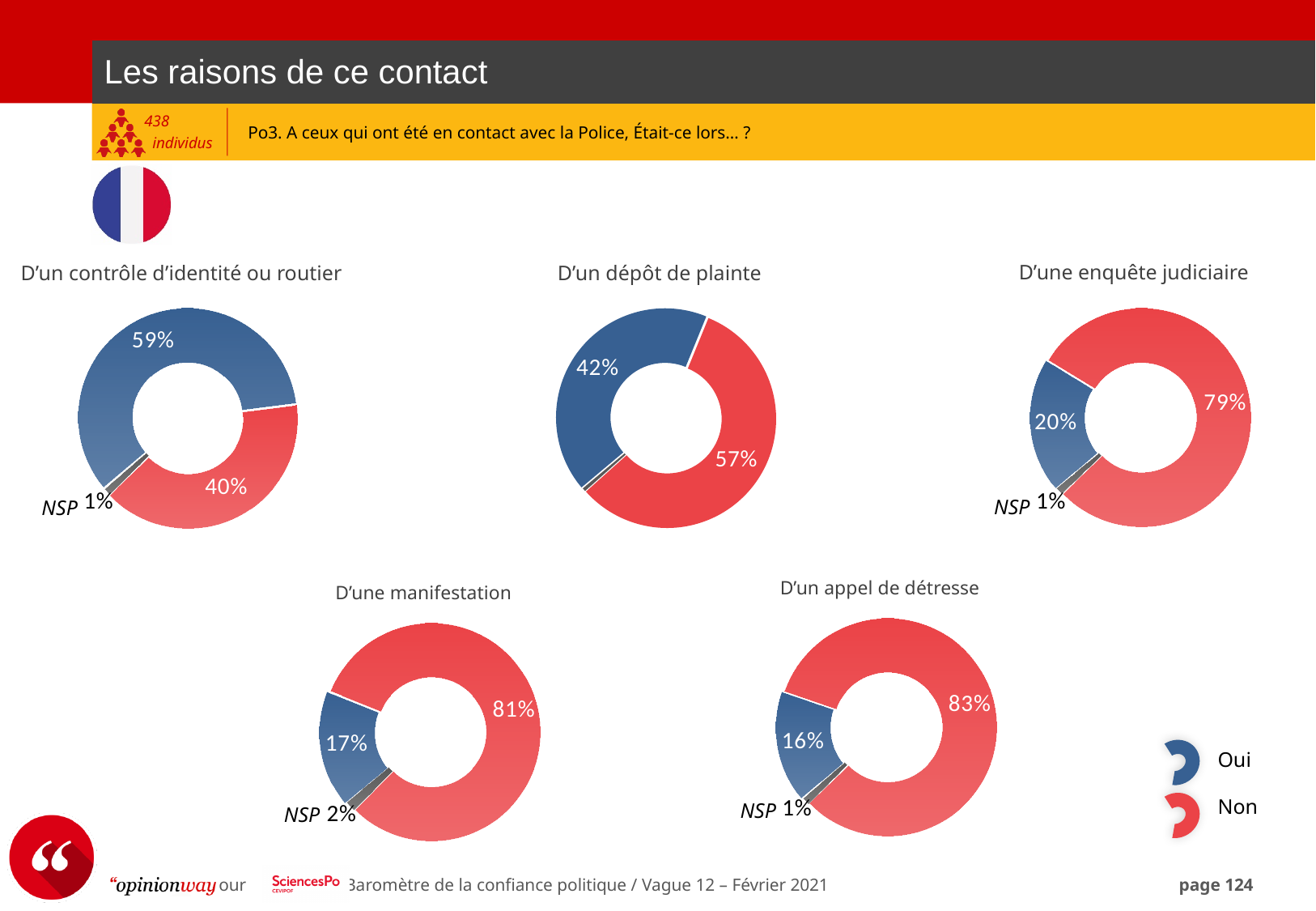
How many donut charts are shown on the slide? 5 In the 'D'un contrôle d'identité ou routier' chart, what is the value for Oui? 59% How many entries does the legend list? 2 What kind of chart is used for 'D'un appel de détresse'? Donut (pie) chart In the 'D'une manifestation' chart, which response has the smallest share? NSP In the 'D'une enquête judiciaire' chart, what is the value for Oui? 20% In the 'D'un contrôle d'identité ou routier' chart, which response has the largest share? Oui In the 'D'un dépôt de plainte' chart, what is the value for Non? 57% In the 'D'une enquête judiciaire' chart, which is larger, Oui or Non? Non In the 'D'une manifestation' chart, what is the value for NSP? 2% In the 'D'un dépôt de plainte' chart, what is the difference between Non and Oui? 15% In the 'D'un appel de détresse' chart, what is the value for Non? 83%